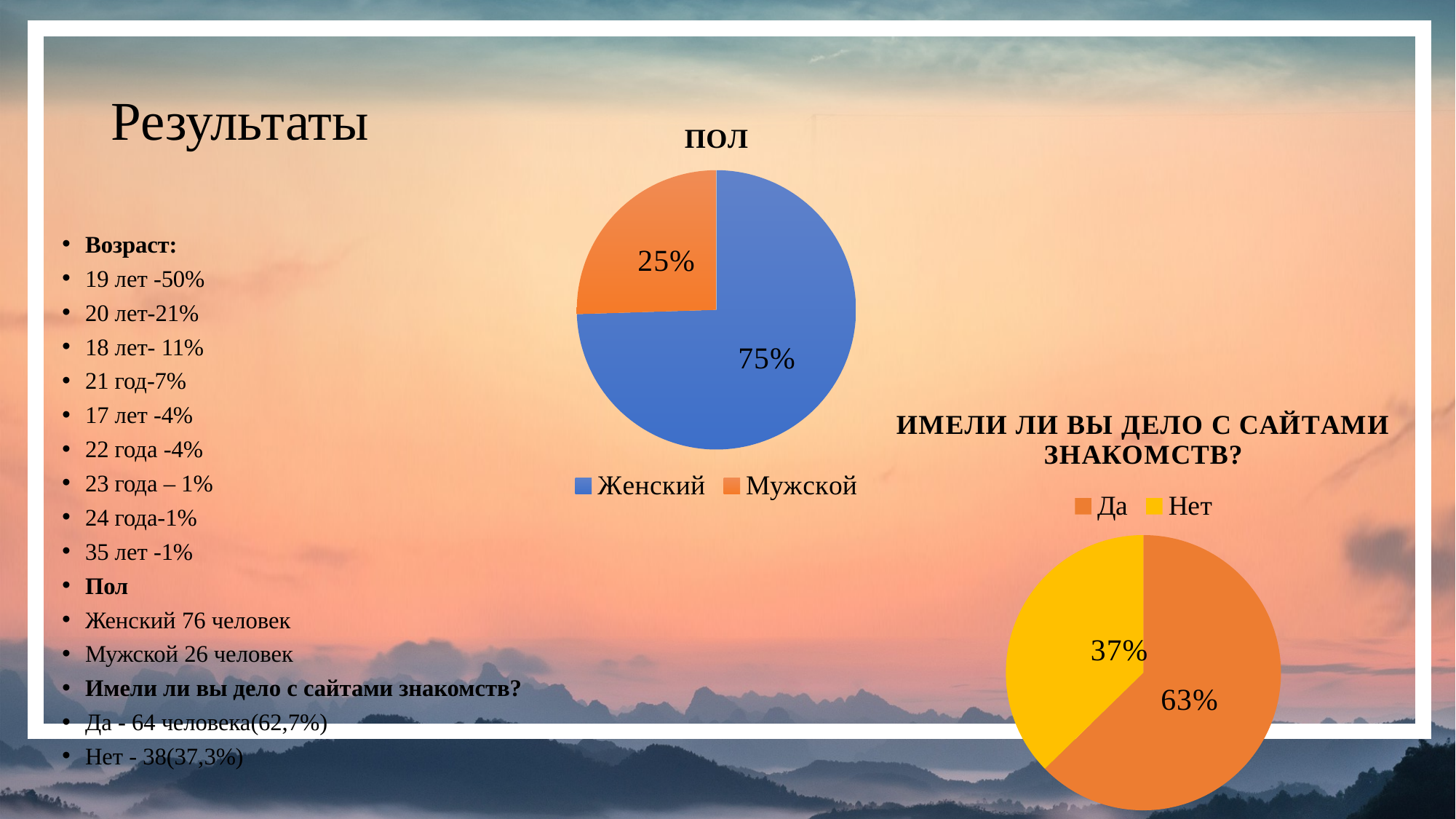
In the chart titled "пол", which category has the largest slice? Женский In the chart titled "пол", which category has the smallest slice? Мужской In the chart titled "ИМЕЛИ ЛИ ВЫ ДЕЛО С САЙТАМИ ЗНАКОМСТВ?", what colour is the Нет slice? yellow In the chart titled "пол", what share of the pie is Женский? 75% In the chart titled "ИМЕЛИ ЛИ ВЫ ДЕЛО С САЙТАМИ ЗНАКОМСТВ?", what share of the pie is Да? 63% In the chart titled "ИМЕЛИ ЛИ ВЫ ДЕЛО С САЙТАМИ ЗНАКОМСТВ?", what share of the pie is Нет? 37% In the chart titled "пол", what is the difference between the Женский and Мужской shares? 50% What kind of chart is the chart titled "пол"? pie chart In the chart titled "ИМЕЛИ ЛИ ВЫ ДЕЛО С САЙТАМИ ЗНАКОМСТВ?", what is the difference between the Да and Нет shares? 26% In the chart titled "пол", how many categories does the legend list? 2 In the chart titled "ИМЕЛИ ЛИ ВЫ ДЕЛО С САЙТАМИ ЗНАКОМСТВ?", which is larger, Да or Нет? Да